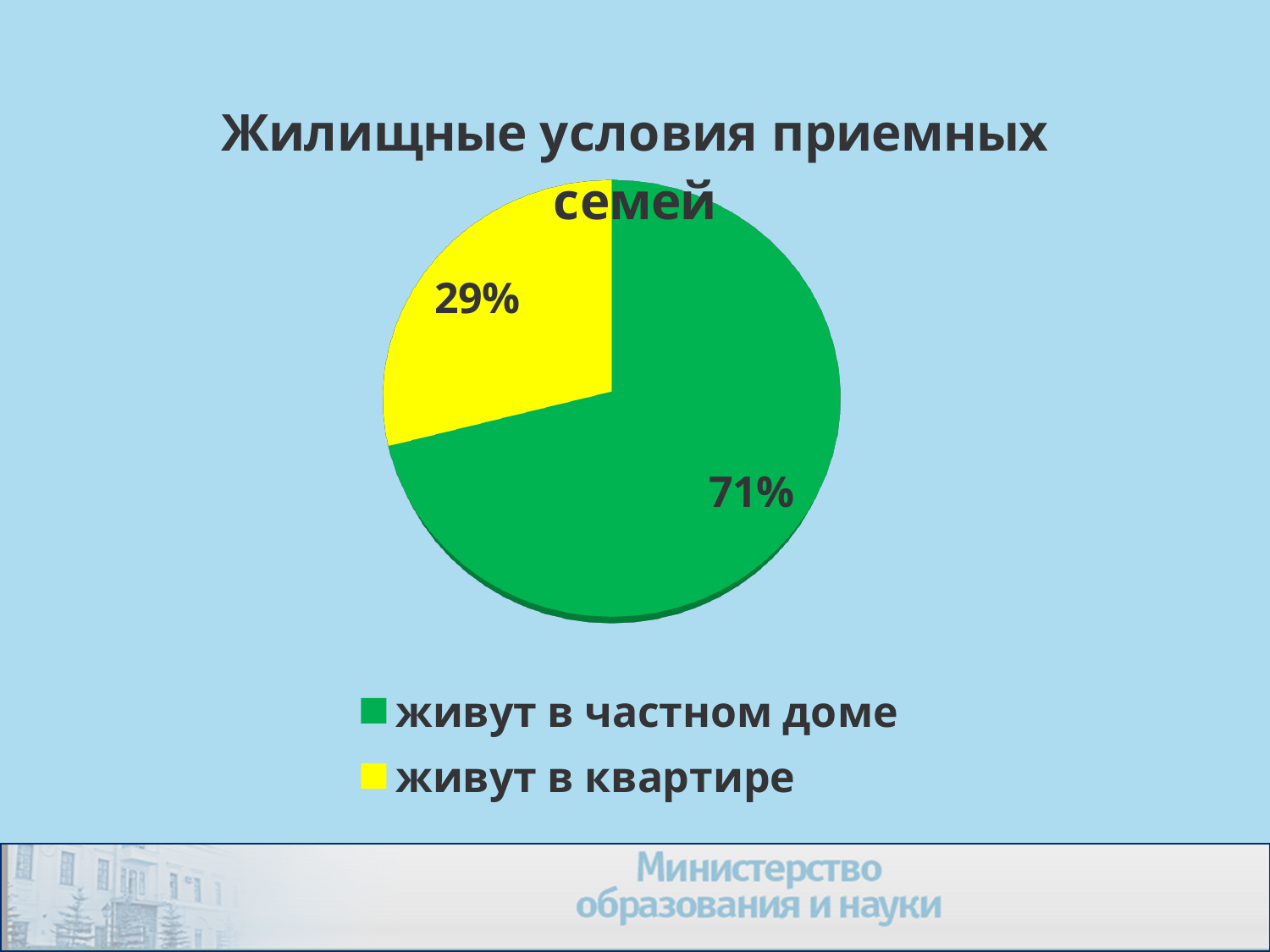
Which category has the smallest slice of the pie? живут в квартире What share of the pie is for 'живут в частном доме'? 71% Which is larger: the share for 'живут в частном доме' or for 'живут в квартире'? живут в частном доме What is the difference in percentage points between 'живут в частном доме' and 'живут в квартире'? 42 What colour is the slice for 'живут в квартире'? yellow How many slices does the pie chart have? 2 What kind of chart is shown on the slide? pie chart How many entries does the legend list? 2 Which category has the largest slice of the pie? живут в частном доме What is the title of the chart? Жилищные условия приемных семей What share of the pie is for 'живут в квартире'? 29%